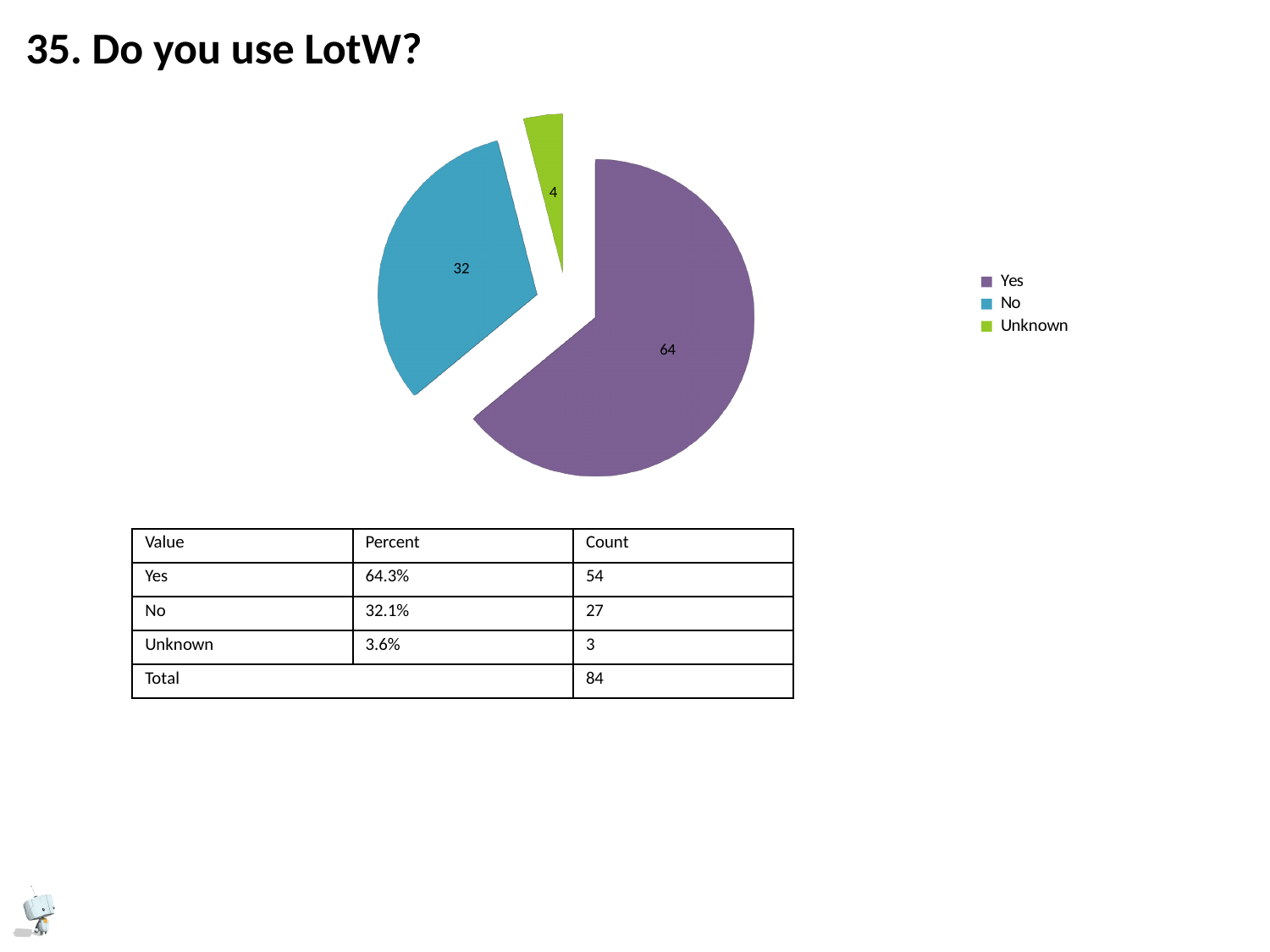
How many entries does the legend of the pie chart list? 3 Which category has the largest slice in the pie chart? Yes What is the difference between the data labels of the Yes and No slices? 32 What is the data label shown on the Unknown slice of the pie chart? 4 What colour is the Yes slice in the pie chart? purple What type of chart is shown on the slide? pie chart How many slices does the pie chart have? 3 Which legend entry is shown in green? Unknown Which category has the smallest slice in the pie chart? Unknown What is the data label shown on the Yes slice of the pie chart? 64 Which slice is larger in the pie chart, No or Unknown? No What is the data label shown on the No slice of the pie chart? 32